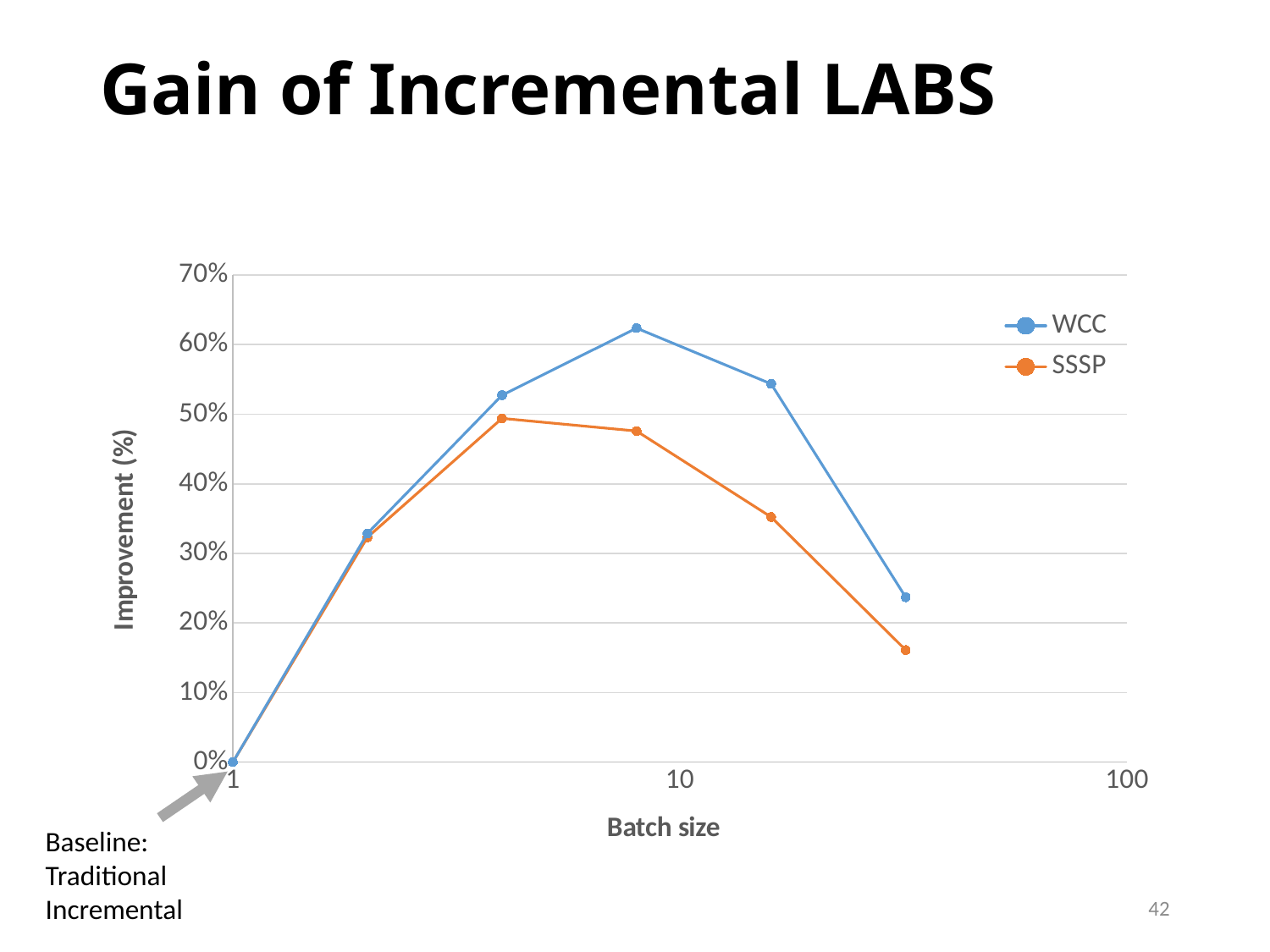
Is the rightmost (largest batch size) value of the SSSP series greater or less than 20%? less Is the rightmost (largest batch size) value of the WCC series greater or less than 20%? greater What is the label of the y axis? Improvement (%) How does the WCC improvement change as batch size increases along the x axis? rises then falls Is the highest value of the WCC series greater or less than 60%? greater What kind of chart is shown on the slide? line chart Which series reaches the higher peak improvement, WCC or SSSP? WCC How many data points are plotted for the WCC series? 6 How many series does the legend list? 2 At the largest batch size plotted, which series has the higher improvement, WCC or SSSP? WCC What is the improvement value for WCC at batch size 1? 0%